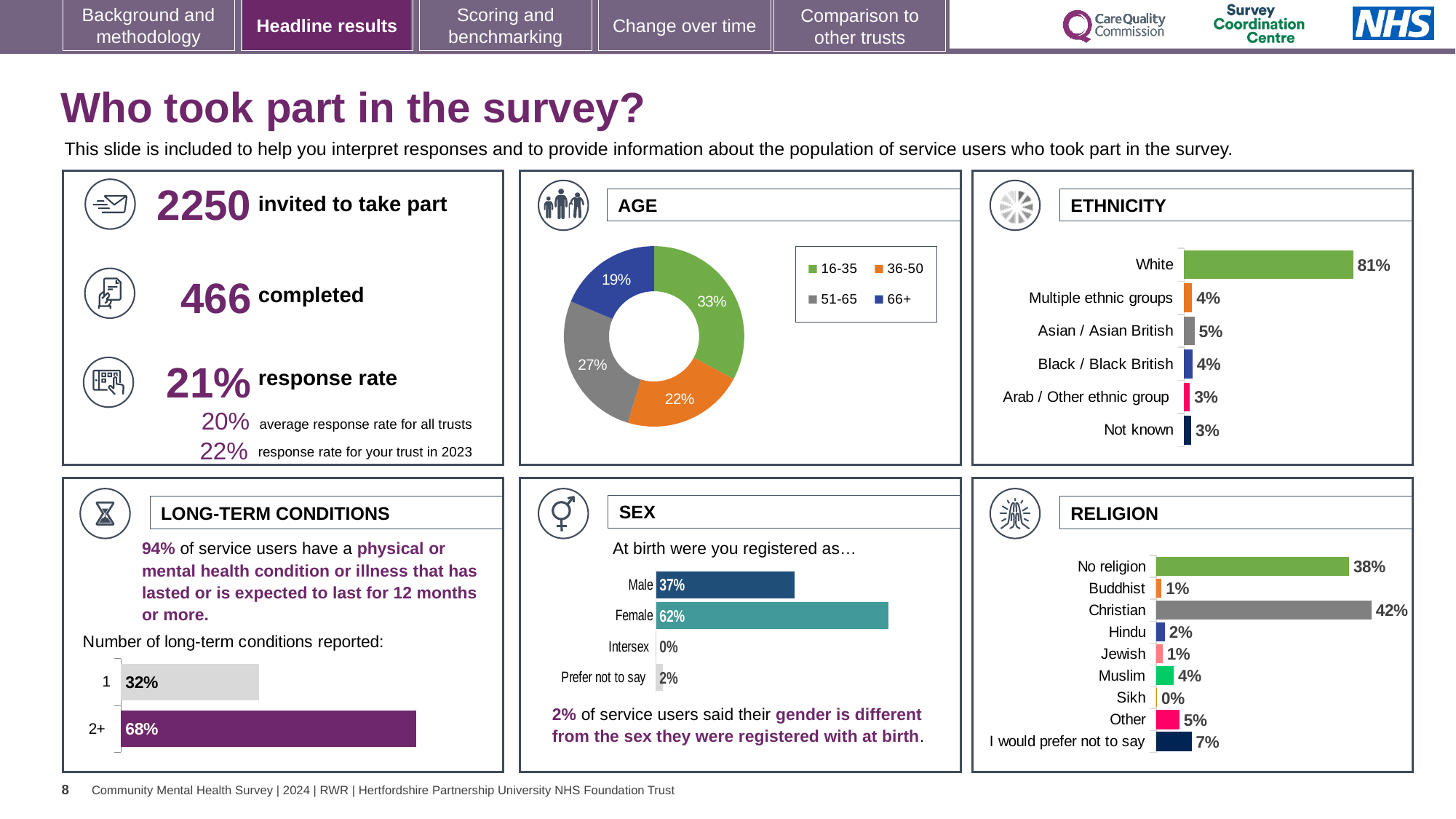
In the AGE chart, what percentage of respondents were aged 16-35? 33% What kind of chart is the AGE chart? Donut chart In the ETHNICITY chart, what is the difference between White and Multiple ethnic groups? 77% In the SEX chart, what is the difference between Female and Male? 25% How many age groups does the legend of the AGE chart list? 4 In the AGE chart, which age group has the smallest share? 66+ In the RELIGION chart, which category has the highest value? Christian In the LONG-TERM CONDITIONS chart, which is larger, the value for 1 condition or for 2+ conditions? 2+ In the ETHNICITY chart, what is the value for Asian / Asian British? 5% In the ETHNICITY chart, which category has the highest value? White In the SEX chart, what is the value for Female? 62% How many categories are shown in the ETHNICITY chart? 6